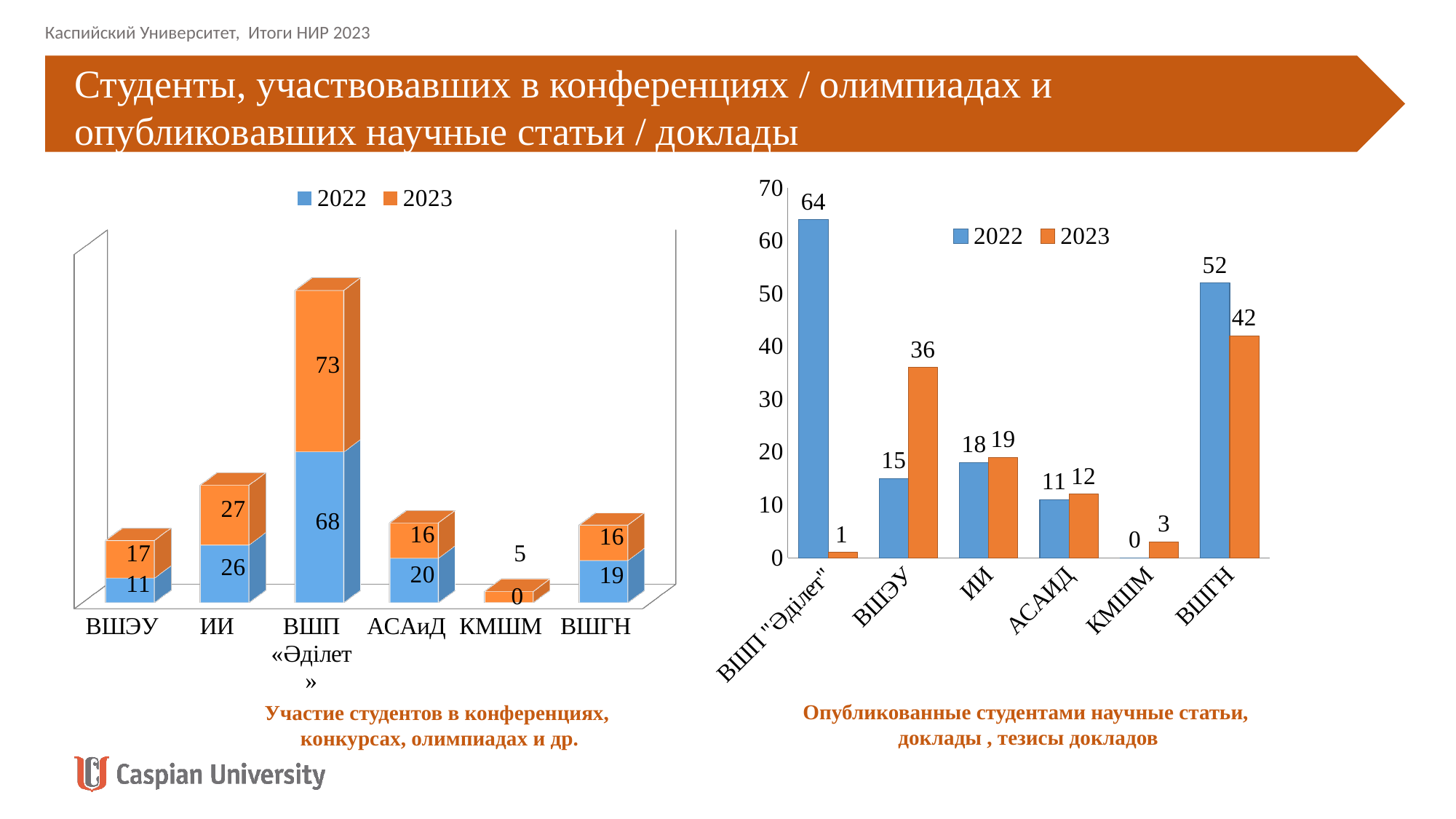
In the left chart (Участие студентов в конференциях, конкурсах, олимпиадах и др.), how many categories are shown on the x axis? 6 In the left chart (Участие студентов в конференциях, конкурсах, олимпиадах и др.), which category has the highest 2022 value? ВШП «Әділет» In the left chart (Участие студентов в конференциях, конкурсах, олимпиадах и др.), what is the 2023 value for ВШП «Әділет»? 73 What type of chart is the right chart (Опубликованные студентами научные статьи, доклады, тезисы докладов)? Bar chart In the right chart (Опубликованные студентами научные статьи, доклады, тезисы докладов), which is larger for ВШЭУ: the 2022 value or the 2023 value? 2023 In the left chart (Участие студентов в конференциях, конкурсах, олимпиадах и др.), what is the 2022 value for ИИ? 26 In the right chart (Опубликованные студентами научные статьи, доклады, тезисы докладов), what is the 2022 value for ВШП "Әділет"? 64 In the right chart (Опубликованные студентами научные статьи, доклады, тезисы докладов), what is the difference between the 2022 and 2023 values for ВШГН? 10 In the right chart (Опубликованные студентами научные статьи, доклады, тезисы докладов), which category has the lowest 2023 value? ВШП "Әділет" In the left chart (Участие студентов в конференциях, конкурсах, олимпиадах и др.), what is the difference between the 2023 and 2022 values for АСАиД? 4 In the left chart (Участие студентов в конференциях, конкурсах, олимпиадах и др.), what is the total of the stacked bar for ВШЭУ? 28 In the right chart (Опубликованные студентами научные статьи, доклады, тезисы докладов), how many series does the legend list? 2